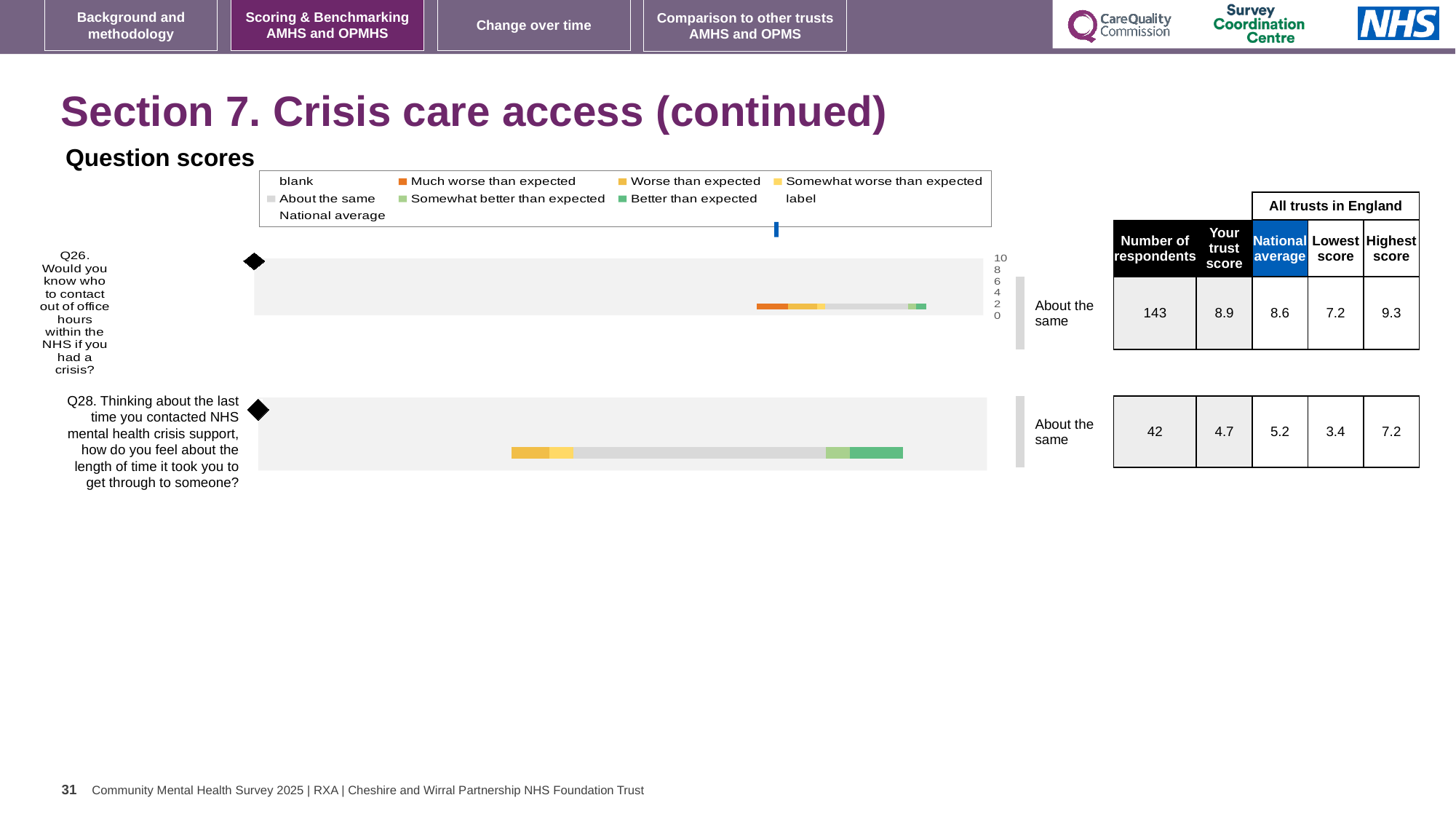
What benchmark category is shown next to the chart for both Q26 and Q28? About the same What is the national average for Q26? 8.6 How many questions are plotted in the question scores chart? 2 What is the difference between the trust score and the national average for Q26? 0.3 Which question has the higher trust score, Q26 or Q28? Q26 What is the lowest score among all trusts in England for Q28? 3.4 What is the trust score for Q28 (length of time it took to get through to someone)? 4.7 What kind of chart is used to show the question scores on this slide? bar chart What is the difference between the highest and lowest scores for Q28 across all trusts in England? 3.8 What is the trust score for Q26 (Would you know who to contact out of office hours within the NHS if you had a crisis?)? 8.9 How many respondents answered Q26? 143